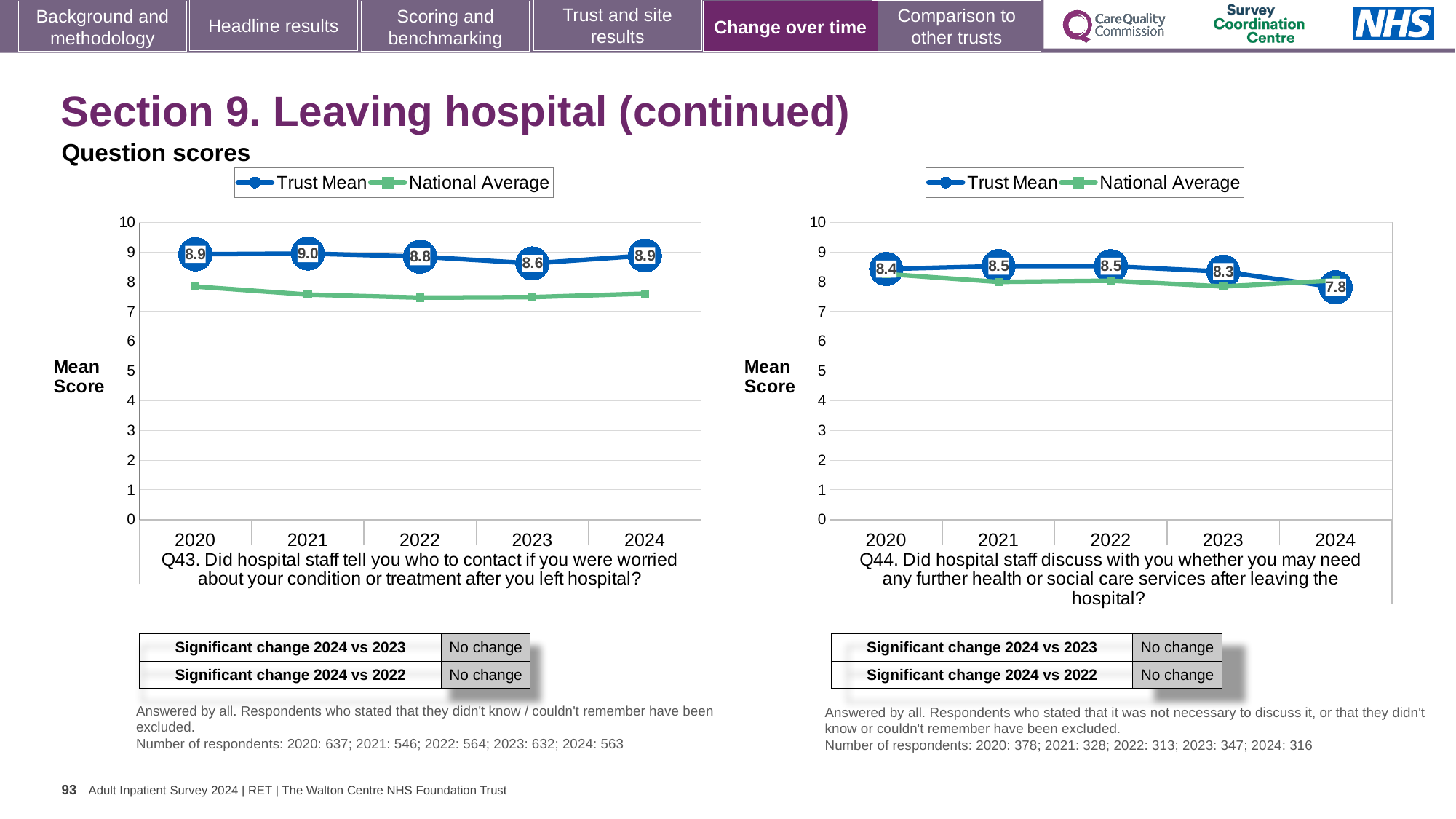
In the Q43 chart (left), is the National Average for 2022 greater or less than 8? less How many years are plotted on the x axis of the Q44 chart (right)? 5 In the Q44 chart (right), what is the difference between the Trust Mean scores for 2023 and 2024? 0.5 In the Q44 chart (right), what is the Trust Mean score for 2024? 7.8 In the Q43 chart (left), which year has the lowest Trust Mean score? 2023 What type of chart is the Q44 chart (right)? Line chart In the Q44 chart (right), does the Trust Mean rise or fall from 2022 to 2024? Fall How many series does the legend of the Q43 chart (left) list? 2 In the Q43 chart (left), what is the Trust Mean score for 2021? 9.0 In the Q44 chart (right), which year has the lowest Trust Mean score? 2024 In the Q43 chart (left), which year has the highest Trust Mean score? 2021 In the Q43 chart (left), is the Trust Mean for 2020 or 2023 higher? 2020